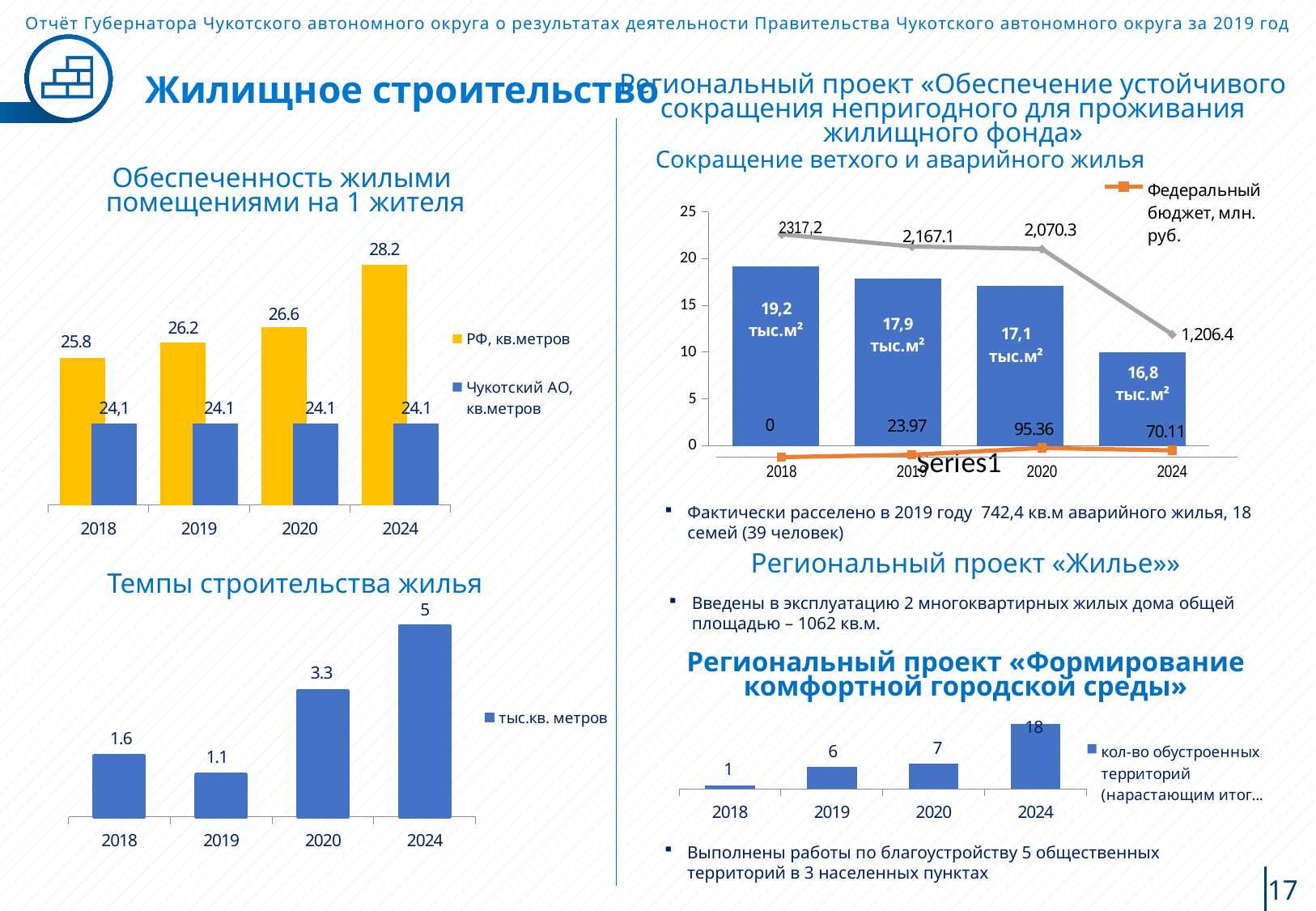
In the chart 'Обеспеченность жилыми помещениями на 1 жителя', which year has the highest value for РФ, кв.метров? 2024 In the chart 'Темпы строительства жилья', which year has the lowest value? 2019 How many series does the legend of the chart 'Обеспеченность жилыми помещениями на 1 жителя' list? 2 In the chart 'Сокращение ветхого и аварийного жилья', do the bar values rise or fall from 2018 to 2024? fall In the chart 'Региональный проект «Формирование комфортной городской среды»', how many years are shown on the x axis? 4 In the chart 'Обеспеченность жилыми помещениями на 1 жителя', what is the value for РФ, кв.метров in 2024? 28.2 In the chart 'Сокращение ветхого и аварийного жилья', what is the value of the Федеральный бюджет, млн. руб. series in 2020? 95.36 In the chart 'Сокращение ветхого и аварийного жилья', what is the bar value for 2019? 17,9 тыс.м² In the chart 'Обеспеченность жилыми помещениями на 1 жителя', what is the difference between the РФ value and the Чукотский АО value in 2020? 2.5 What kind of chart is 'Темпы строительства жилья'? bar chart In the chart 'Темпы строительства жилья', what is the value for 2020? 3.3 In the chart 'Региональный проект «Формирование комфортной городской среды»', what is the value for 2024? 18